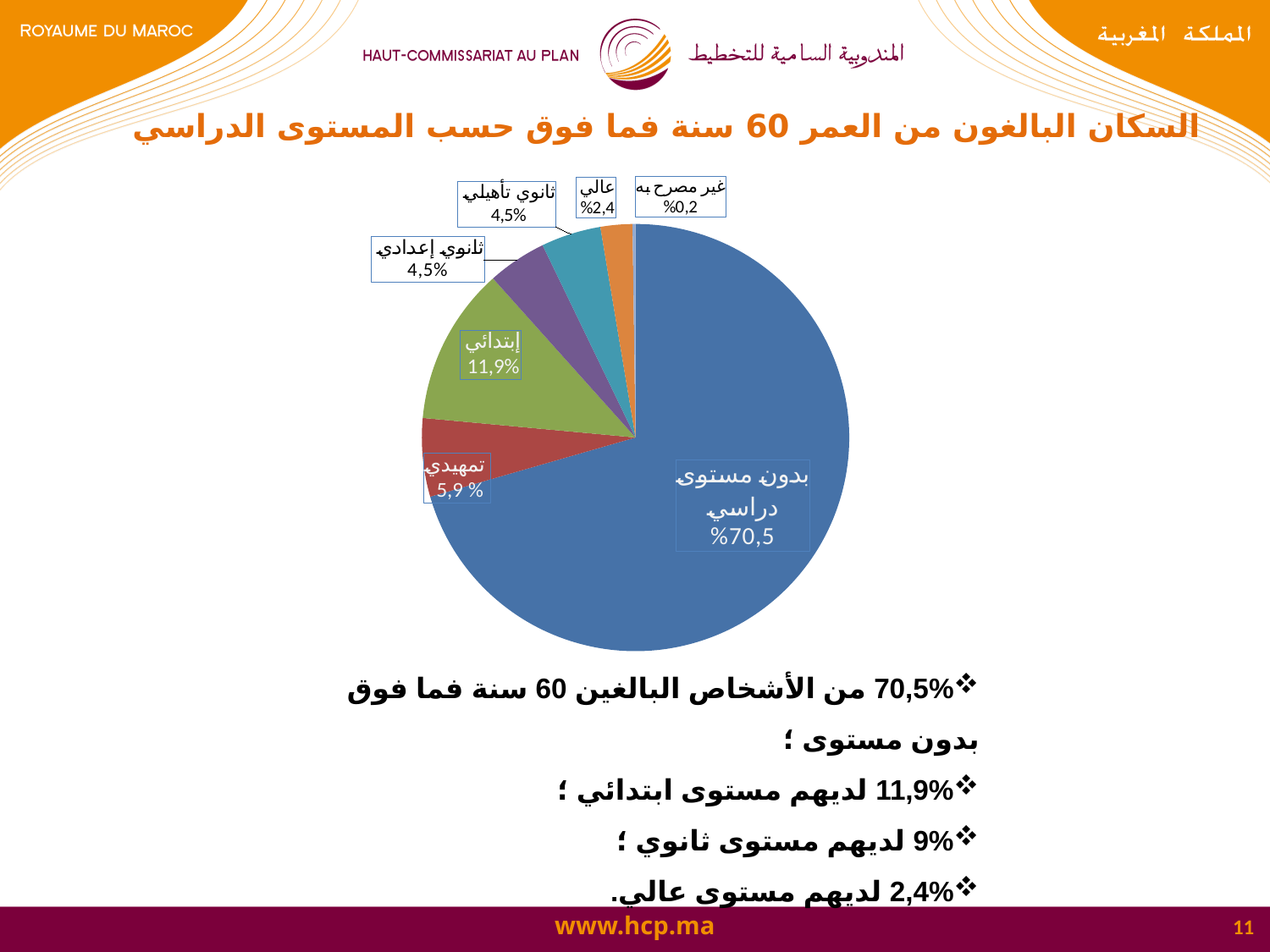
What kind of chart is shown on the slide? pie chart What is the value shown for the تمهيدي slice? 5,9% What is the difference between the إبتدائي slice and the تمهيدي slice? 6 percentage points Which category has the largest slice of the pie? بدون مستوى دراسي What is the value shown for the عالي slice? 2,4% What share of the pie is labelled بدون مستوى دراسي? 70,5% What is the title of the chart on the slide? السكان البالغون من العمر 60 سنة فما فوق حسب المستوى الدراسي Which is larger, the إبتدائي slice or the ثانوي إعدادي slice? إبتدائي Which category has the smallest slice of the pie? غير مصرح به How many slices does the pie chart have? 7 What is the value shown for the غير مصرح به slice? 0,2% What is the value shown for the إبتدائي slice? 11,9%